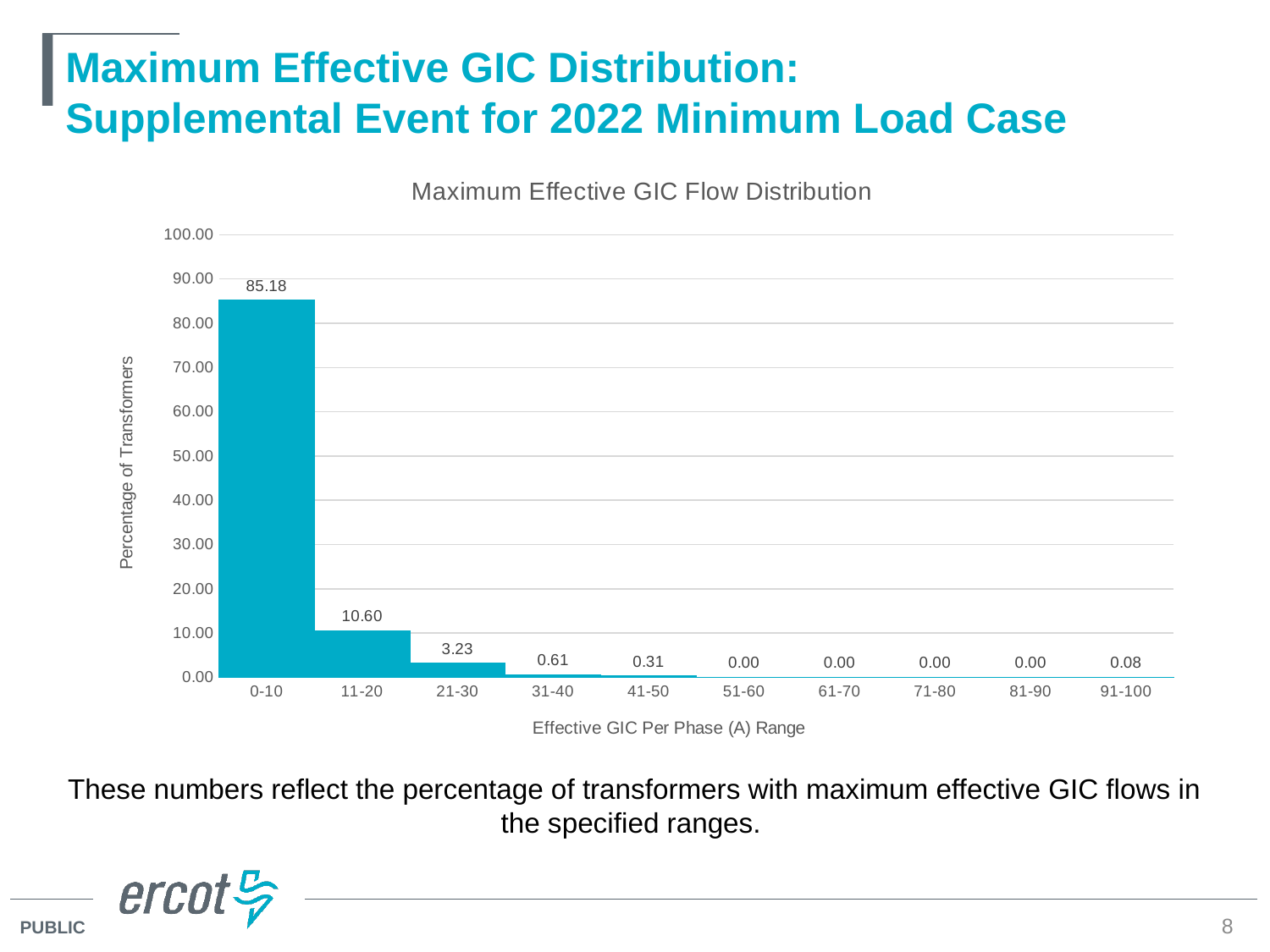
What is the value for the 21-30 range? 3.23 What is the value for the 11-20 range? 10.60 What is the title of the chart? Maximum Effective GIC Flow Distribution What is the value for the 91-100 range? 0.08 Do the values generally rise or fall from the 0-10 range to the 41-50 range? Fall Is the value for the 0-10 range greater or less than 80.00? greater What is the difference between the values for the 0-10 and 11-20 ranges? 74.58 What is the value for the 0-10 range? 85.18 What kind of chart is this? Bar chart Which range has the highest percentage of transformers? 0-10 How many ranges are shown on the x axis? 10 Which is larger, the value for 31-40 or the value for 41-50? 31-40